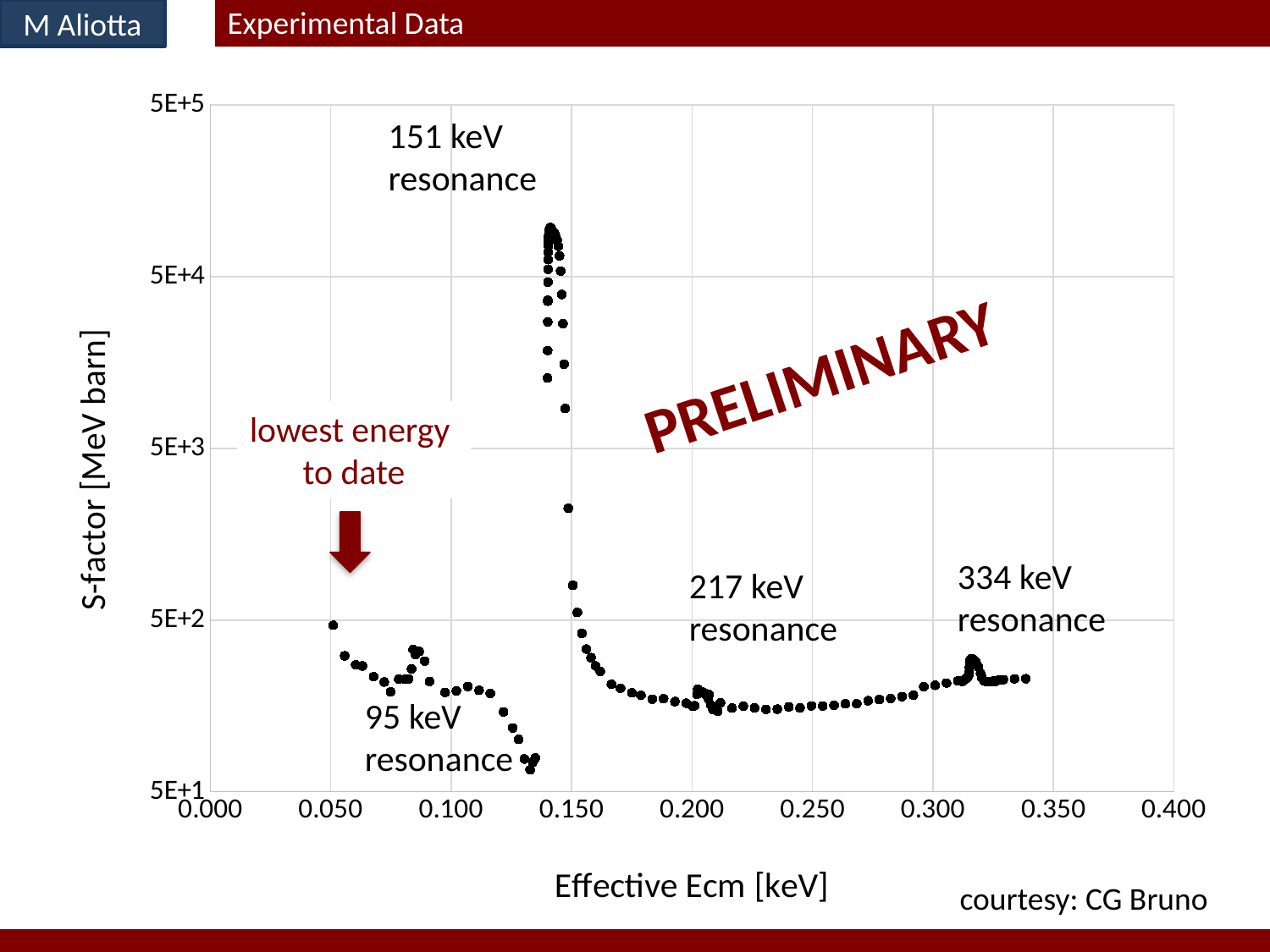
Is the peak S-factor of the 334 keV resonance greater or less than 5E+3? less What word is written diagonally across the chart as a watermark? PRELIMINARY Which has the larger peak S-factor, the 151 keV resonance or the 334 keV resonance? 151 keV resonance How many resonances are labelled on the chart? 4 What is the label of the y axis? S-factor [MeV barn] Is the S-factor at an effective Ecm of 0.250 keV greater or less than 5E+2? less Do the S-factor values rise or fall as effective Ecm increases from 0.150 keV to 0.200 keV? fall What kind of chart is shown on the slide? Scatter plot What is the highest value shown on the x axis? 0.400 Which labelled resonance reaches the highest S-factor value? 151 keV resonance What is the lowest value shown on the y axis? 5E+1 Is the peak S-factor of the 151 keV resonance greater or less than 5E+4? greater